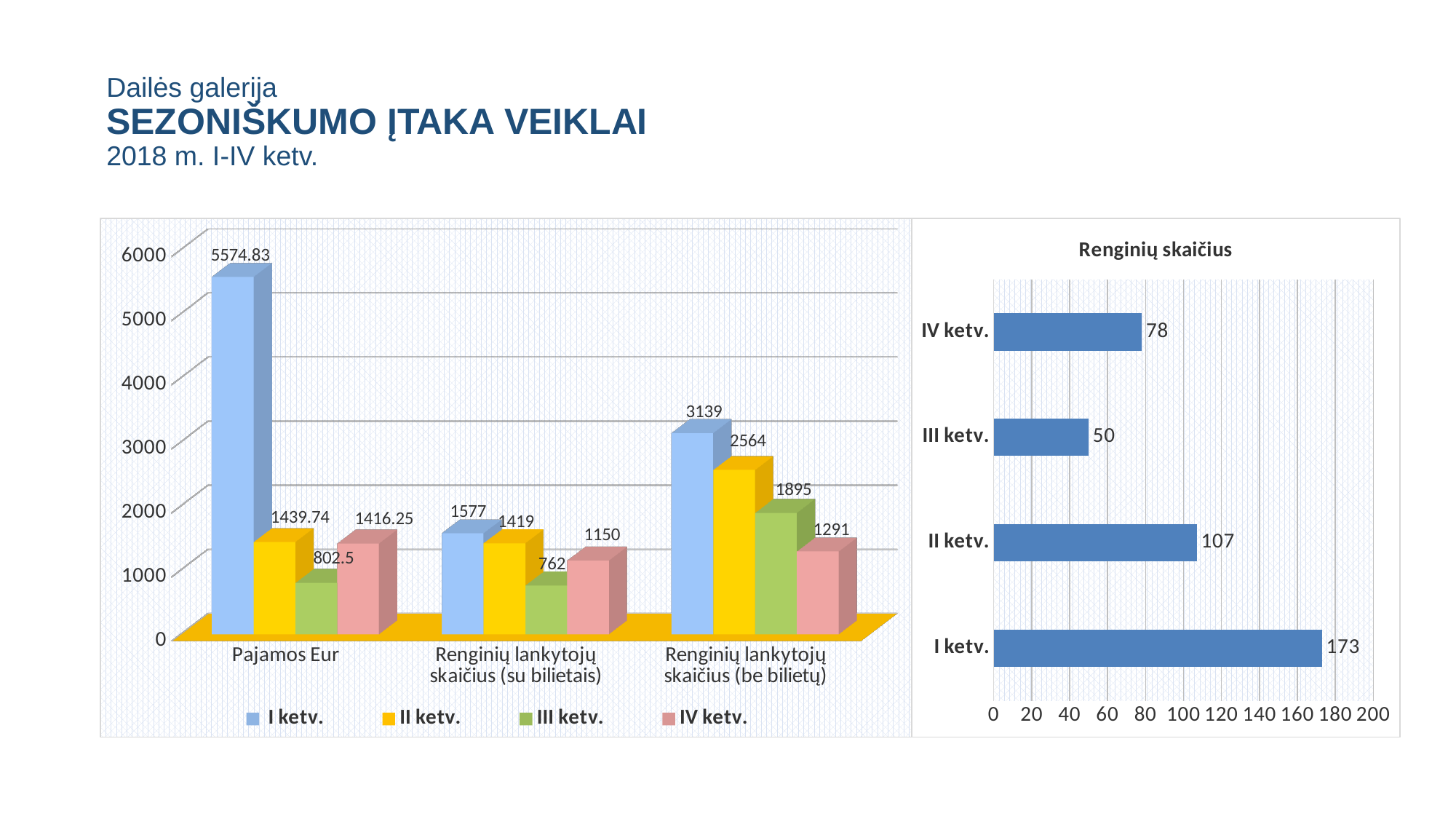
How many series does the legend of the left chart list? 4 In the left chart, what is the difference between the I ketv. and II ketv. values for Renginių lankytojų skaičius (be bilietų)? 575 In the left chart, what is the I ketv. value for Pajamos Eur? 5574.83 In the 'Renginių skaičius' chart on the right, which quarter has the lowest value? III ketv. In the 'Renginių skaičius' chart on the right, what is the value for I ketv.? 173 In the left chart, what is the III ketv. value for Renginių lankytojų skaičius (be bilietų)? 1895 In the left chart, which is larger for Pajamos Eur: II ketv. or IV ketv.? II ketv. In the 'Renginių skaičius' chart on the right, what is the difference between I ketv. and II ketv.? 66 In the 'Renginių skaičius' chart on the right, is the value for IV ketv. greater or less than 100? less In the left chart, which quarter has the lowest value for Renginių lankytojų skaičius (su bilietais)? III ketv. What kind of chart is the 'Renginių skaičius' chart on the right? Bar chart In the 'Renginių skaičius' chart on the right, how many bars are plotted? 4